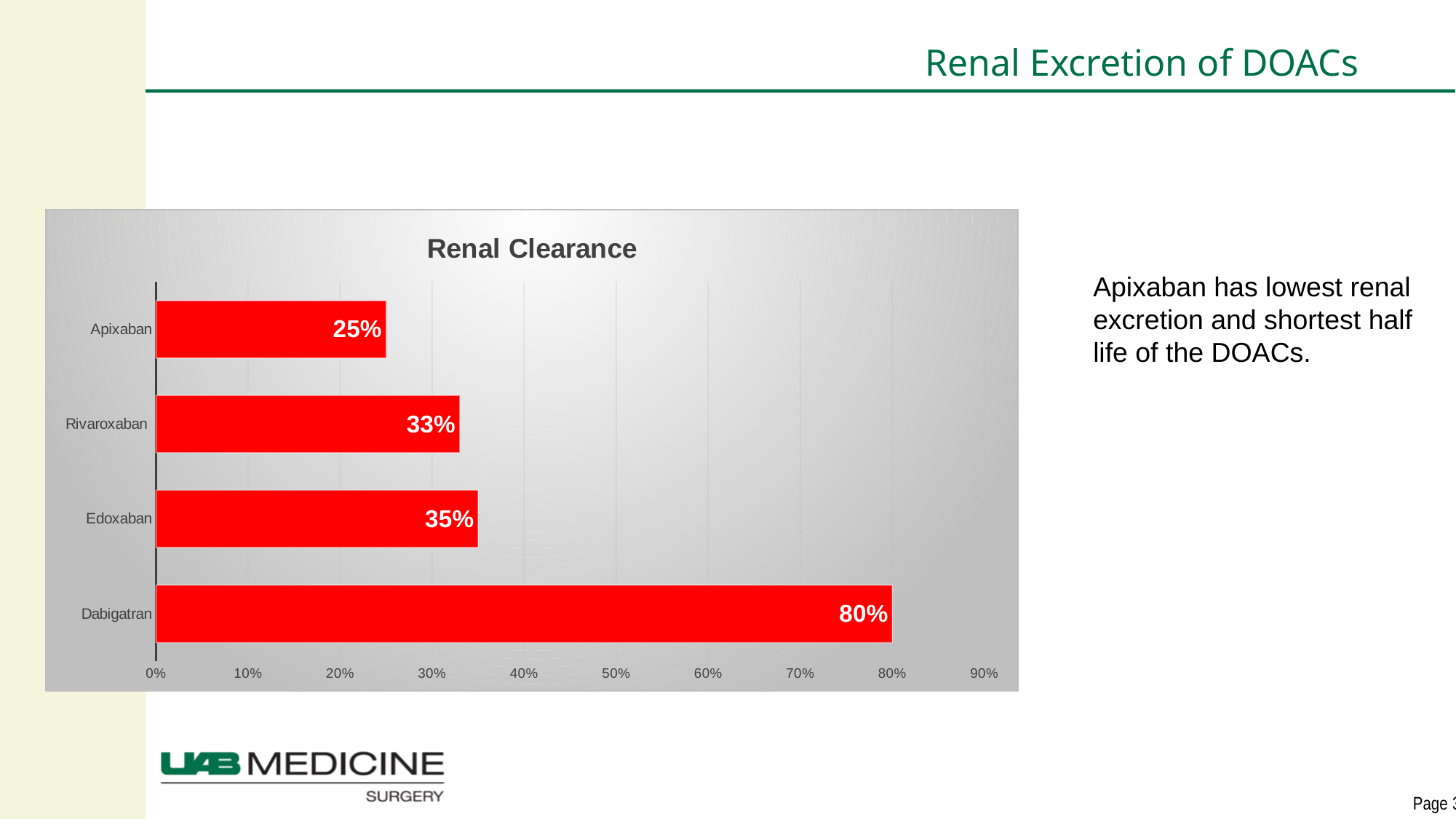
Is the renal clearance for Dabigatran greater or less than 70%? greater What is the renal clearance value for Dabigatran? 80% Which drug has the highest renal clearance? Dabigatran Which has a higher renal clearance, Edoxaban or Apixaban? Edoxaban How many drugs are shown in the chart? 4 What is the difference in renal clearance between Edoxaban and Rivaroxaban? 2% Which drug has the lowest renal clearance? Apixaban What is the renal clearance value for Rivaroxaban? 33% What is the renal clearance value for Apixaban? 25% What kind of chart is shown on the slide? Bar chart What is the title of the chart? Renal Clearance What is the difference in renal clearance between Dabigatran and Apixaban? 55%